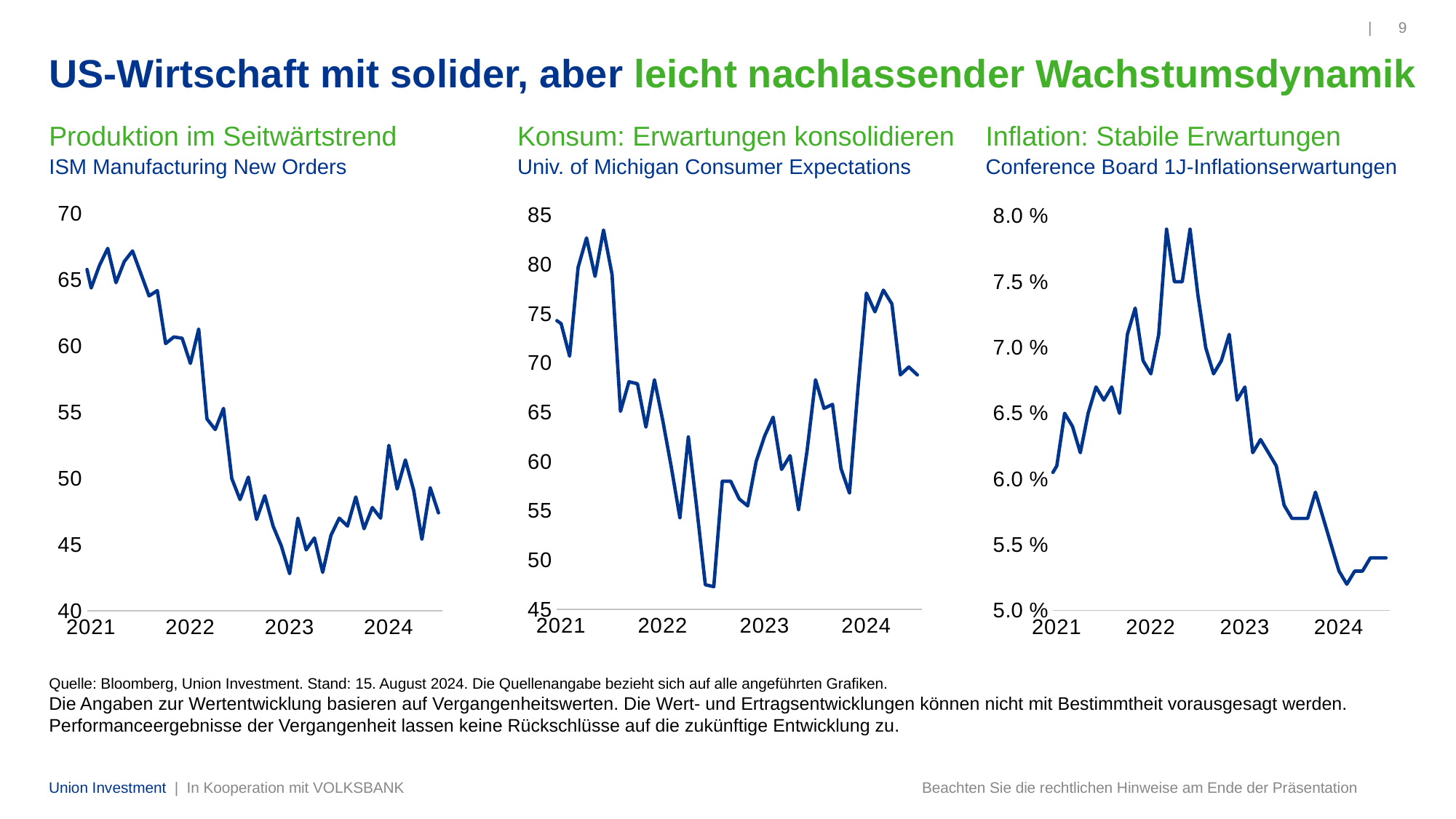
In the left chart 'ISM Manufacturing New Orders', is the lowest point of the line greater or less than 45? less In the right chart 'Conference Board 1J-Inflationserwartungen', does the line rise or fall from the start of 2023 to 2024? fall What kind of chart is the left chart titled 'ISM Manufacturing New Orders'? line chart What is the green heading above the right chart? Inflation: Stabile Erwartungen In the left chart 'ISM Manufacturing New Orders', is the last plotted value in 2024 greater or less than 50? less In the middle chart 'Univ. of Michigan Consumer Expectations', is the highest point of the line greater or less than 80? greater In the middle chart 'Univ. of Michigan Consumer Expectations', does the line end higher or lower than it starts in 2021? lower How many charts are shown on the slide? 3 In the left chart 'ISM Manufacturing New Orders', does the line overall rise or fall from 2021 to 2024? fall